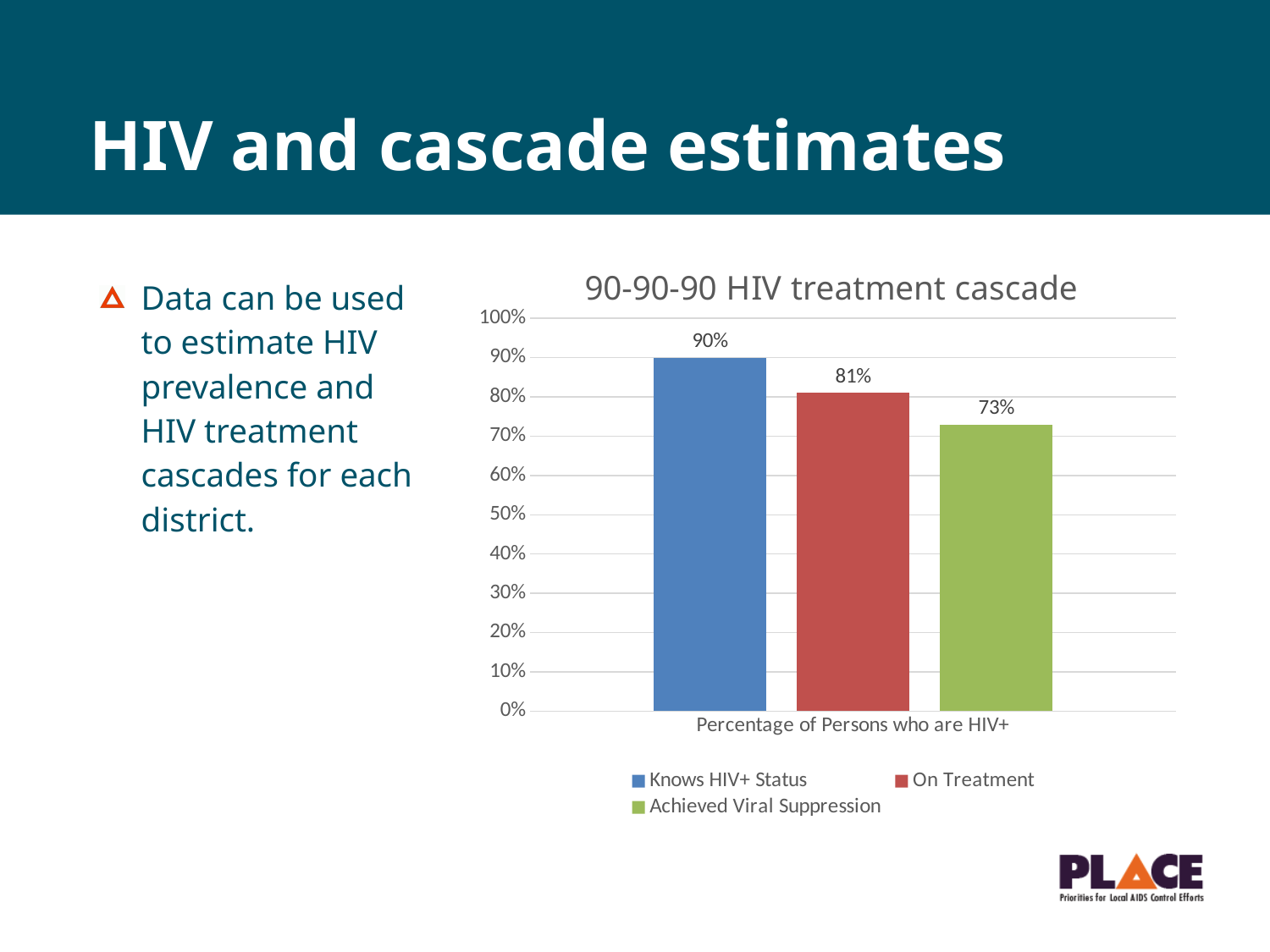
What is the difference between the Knows HIV+ Status value and the On Treatment value? 9% What is the value for On Treatment? 81% Which series has the highest value? Knows HIV+ Status How many series does the legend list? 3 What is the value for Knows HIV+ Status? 90% Which series has the lowest value? Achieved Viral Suppression What is the value for Achieved Viral Suppression? 73% What kind of chart is shown on the slide? Bar chart Is the value for Achieved Viral Suppression greater or less than 80%? less Which is larger, the value for On Treatment or the value for Achieved Viral Suppression? On Treatment What is the title of the chart? 90-90-90 HIV treatment cascade What is the difference between the On Treatment value and the Achieved Viral Suppression value? 8%